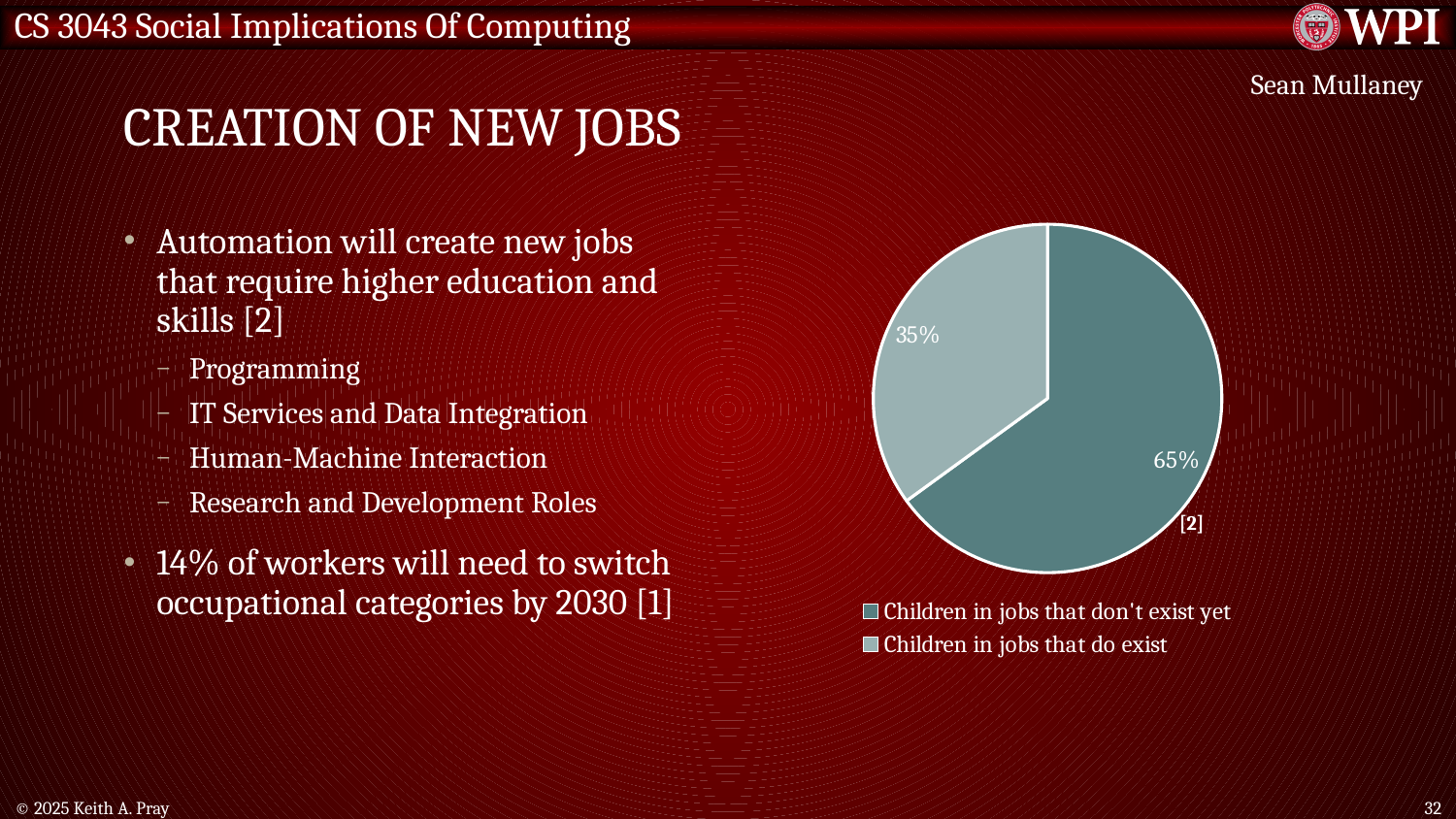
How many entries does the pie chart's legend list? 2 What kind of chart is shown on the slide? pie chart Which slice of the pie chart is drawn in the darker teal colour? Children in jobs that don't exist yet Which slice of the pie chart is the largest? Children in jobs that don't exist yet Which slice of the pie chart is the smallest? Children in jobs that do exist How many slices does the pie chart have? 2 What is the difference in percentage points between the two slices of the pie chart? 30 Which is larger in the pie chart: children in jobs that don't exist yet or children in jobs that do exist? Children in jobs that don't exist yet What percentage of the pie chart is labelled for children in jobs that don't exist yet? 65% What percentage of the pie chart is labelled for children in jobs that do exist? 35% What share of the pie does the slice for children in jobs that do exist represent? 35% What is the first entry listed in the pie chart's legend? Children in jobs that don't exist yet